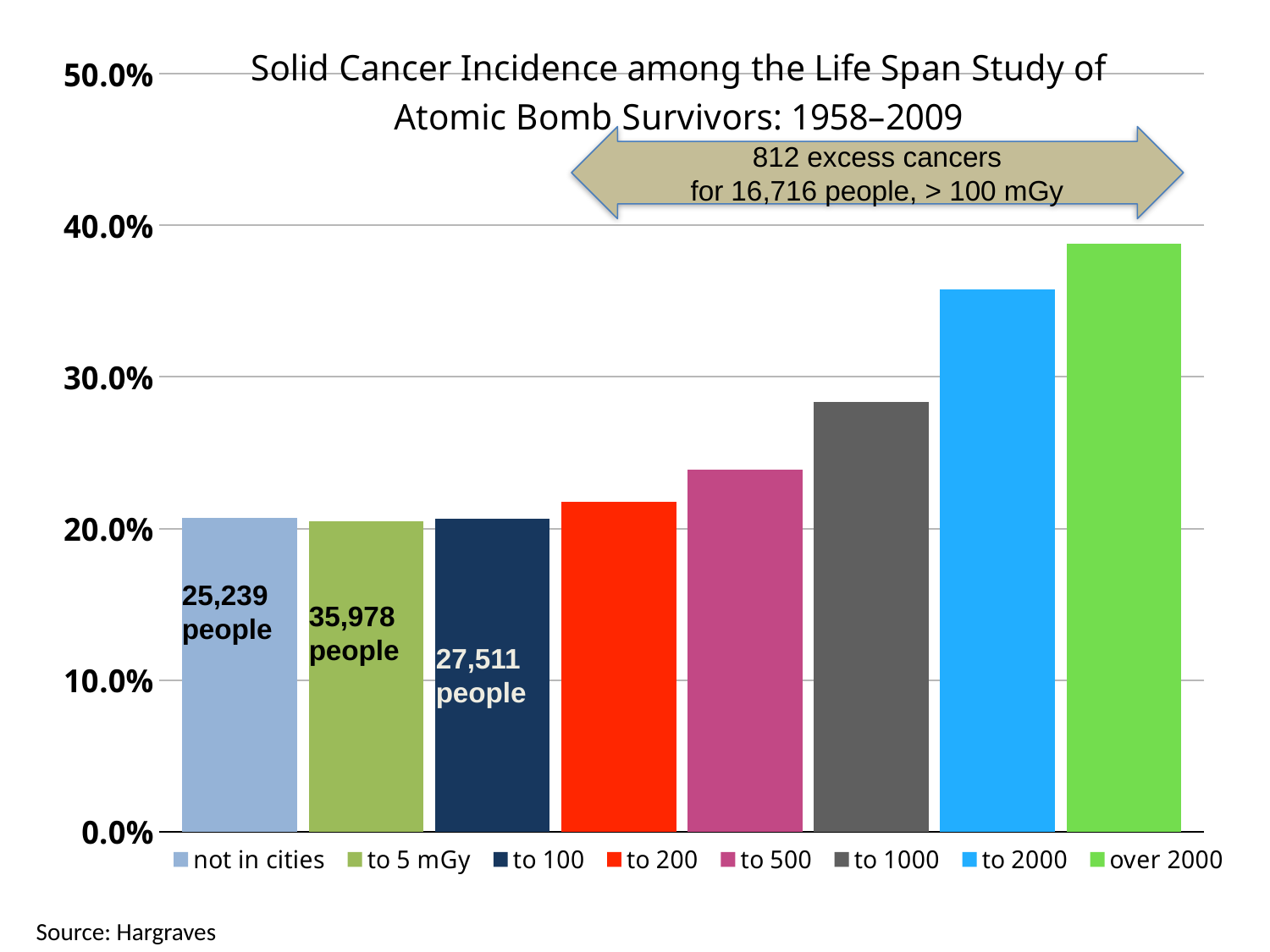
Is the value for 'to 500' greater or less than 20.0%? greater How many entries does the legend list? 8 Which is larger, the value for 'to 500' or the value for 'to 2000'? to 2000 Is the value for 'over 2000' greater or less than 30.0%? greater Is the value for 'to 1000' greater or less than 30.0%? less What is the title of the chart? Solid Cancer Incidence among the Life Span Study of Atomic Bomb Survivors: 1958–2009 Which is larger, the value for 'to 1000' or the value for 'over 2000'? over 2000 How many categories are plotted in the chart? 8 What kind of chart is shown on the slide? bar chart Which category has the highest solid cancer incidence? over 2000 Do the values generally rise or fall moving from left to right across the categories? rise